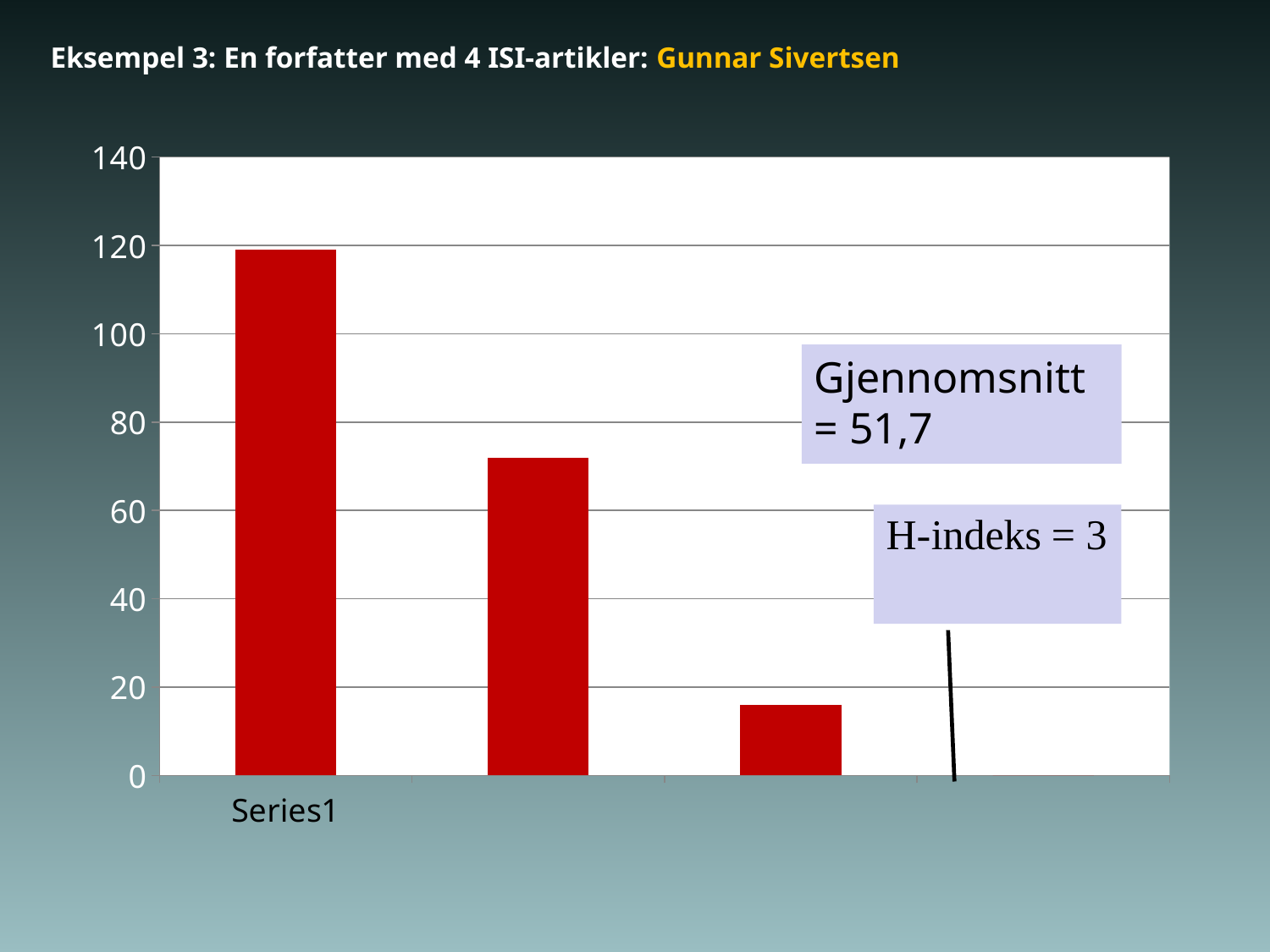
Which is larger, the first bar or the second bar from the left? the first bar Which bar is the tallest? the leftmost bar (Series1) Is the value of the leftmost (tallest) bar greater or less than 100? greater Is the value of the second bar from the left greater or less than 80? less How many bars rise visibly above the zero line? 3 Is the value of the third bar from the left greater or less than 20? less What average (Gjennomsnitt) value is stated in the text box on the chart? 51,7 What kind of chart is shown on the slide? bar chart Do the bar values rise or fall from left to right? fall What is the highest value shown on the vertical axis? 140 Which bar is the lowest? the rightmost bar